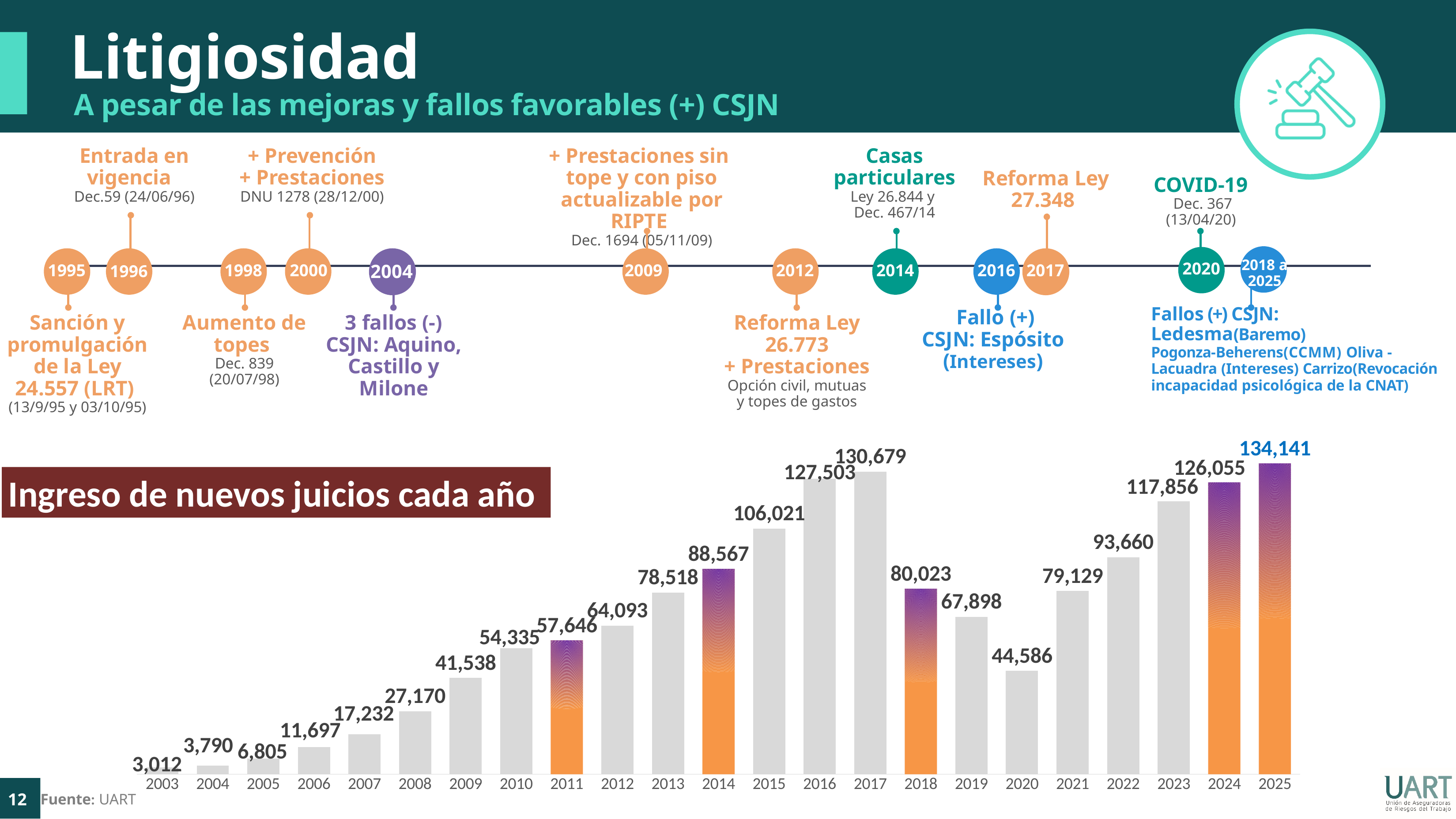
Which year has the highest value in the bar chart? 2025 Which year has the lowest value in the bar chart? 2003 What is the value for 2003 in the bar chart? 3,012 What is the difference between the values for 2017 and 2018 in the bar chart? 50,656 What is the value for 2017 in the bar chart? 130,679 What is the value for 2020 in the bar chart? 44,586 What kind of chart is shown at the bottom of the slide? bar chart Which is larger in the bar chart, the value for 2016 or the value for 2023? 2016 Do the values in the bar chart rise or fall from 2017 to 2020? fall How many years are plotted in the bar chart? 23 What is the title of the bar chart? Ingreso de nuevos juicios cada año What is the difference between the values for 2025 and 2024 in the bar chart? 8,086